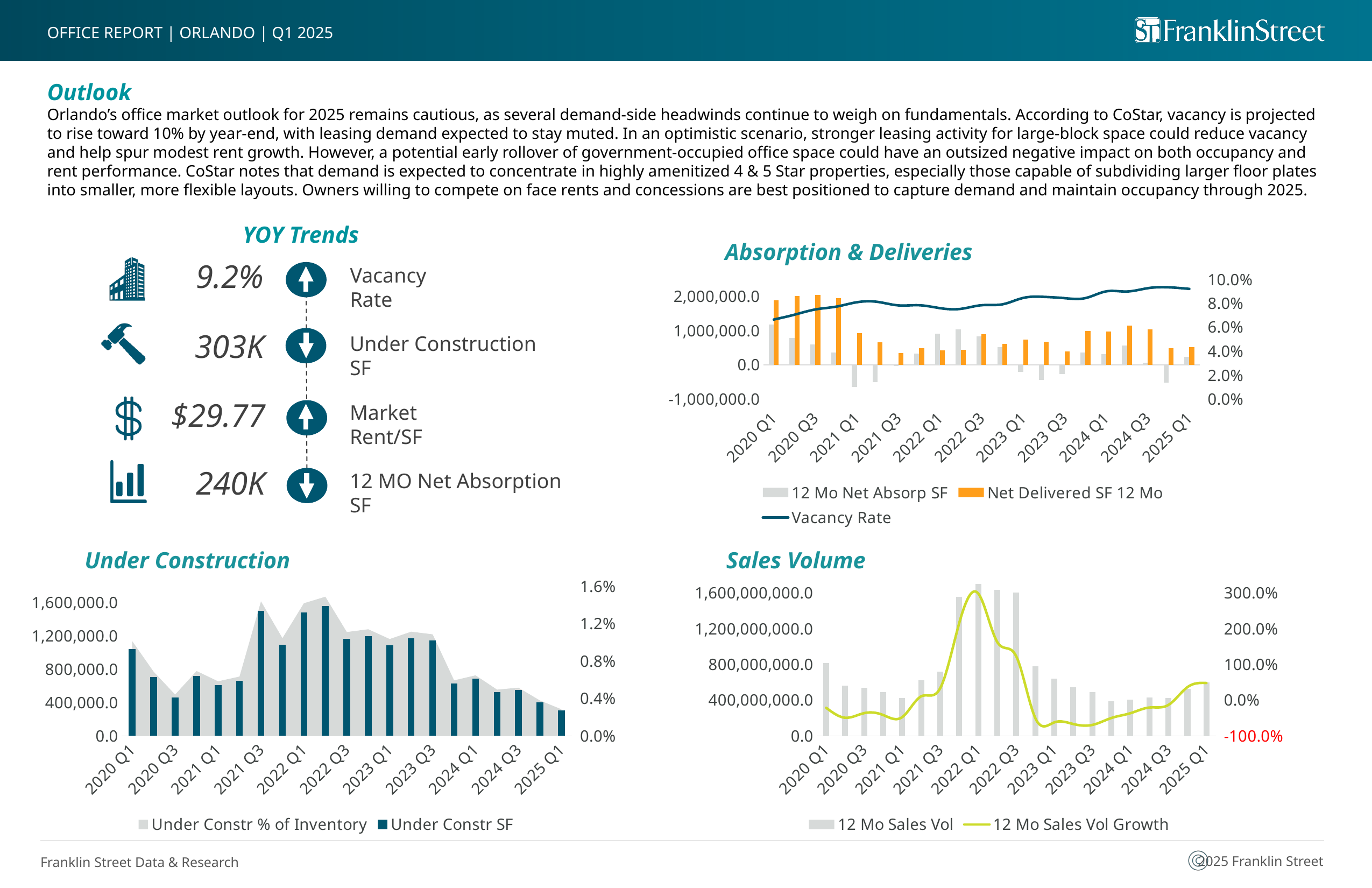
In the Sales Volume chart, which is larger, the 12 Mo Sales Vol for 2022 Q1 or for 2020 Q1? 2022 Q1 In the Absorption & Deliveries chart, is the Vacancy Rate for 2025 Q1 greater or less than 8.0%? greater How many series does the legend of the Absorption & Deliveries chart list? 3 In the Sales Volume chart, which quarter has the highest 12 Mo Sales Vol? 2022 Q1 In the Under Construction chart, is the Under Constr SF value for 2020 Q1 greater or less than 800,000.0? greater In the Absorption & Deliveries chart, does the Vacancy Rate line rise or fall from 2020 Q1 to 2025 Q1? rise In the Sales Volume chart, is the 12 Mo Sales Vol Growth for 2022 Q1 greater or less than 200.0%? greater In the Under Construction chart, which quarter has the lowest Under Constr SF? 2025 Q1 In the Under Construction chart, do the Under Constr SF bars rise or fall from 2023 Q3 to 2025 Q1? fall In the Absorption & Deliveries chart, which series is shown in orange? Net Delivered SF 12 Mo How many quarters are plotted on the x axis of the Under Construction chart? 21